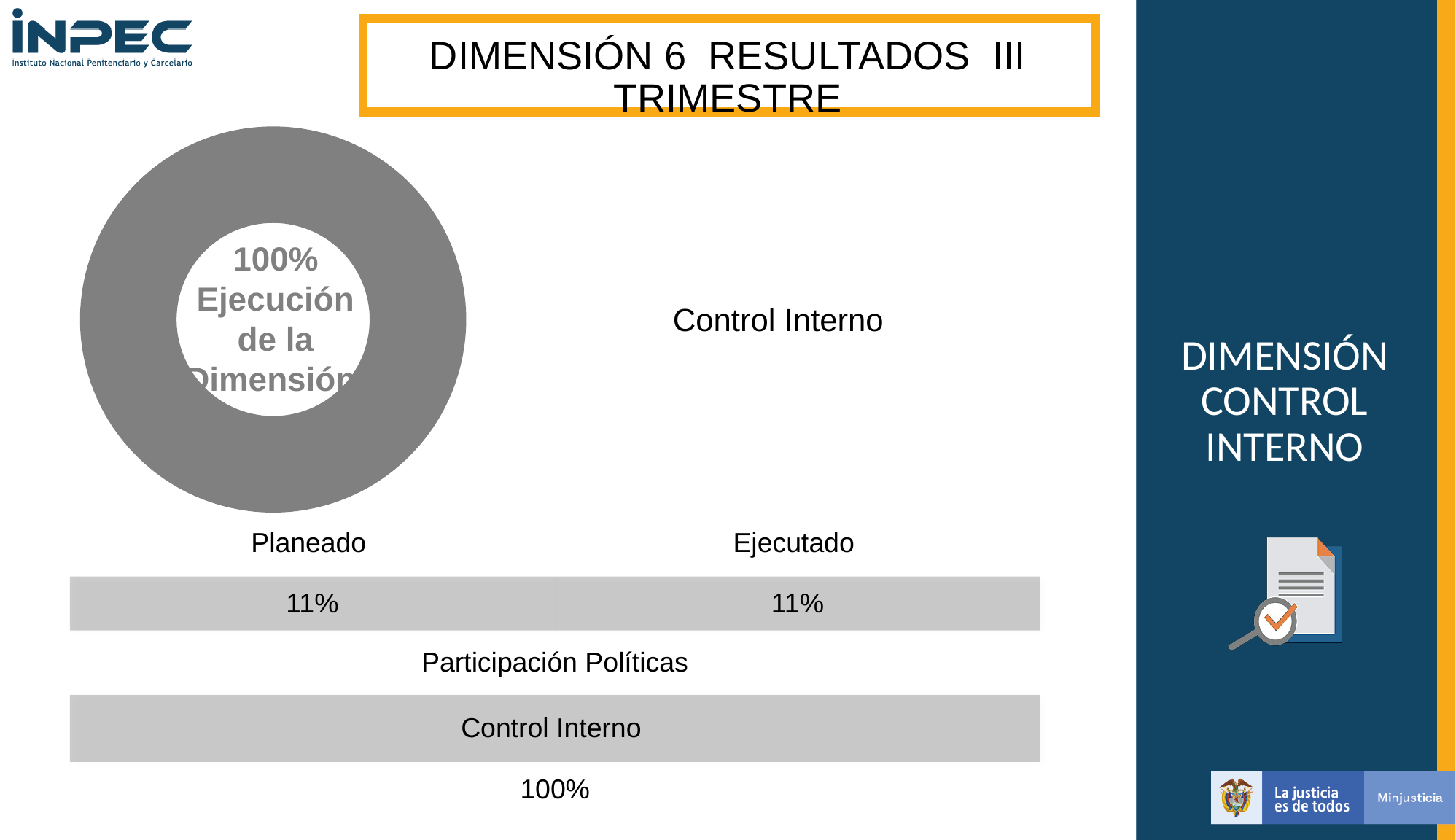
What percentage is printed in the centre of the donut chart? 100% Is the value shown for Control Interno at the bottom of the slide greater or less than 50%? greater What is the Planeado value shown for Participación Políticas? 11% Is the Planeado value for Participación Políticas larger than, smaller than, or equal to the Ejecutado value? equal What is the Ejecutado value shown for Participación Políticas? 11% What text is written in the centre of the donut chart? 100% Ejecución de la Dimensión How many slices does the donut chart have? 1 What is the difference between the Planeado and Ejecutado values for Participación Políticas? 0% What label appears to the right of the donut chart? Control Interno What percentage is shown for Control Interno at the bottom of the slide? 100% What kind of chart is shown on the left of the slide? donut chart